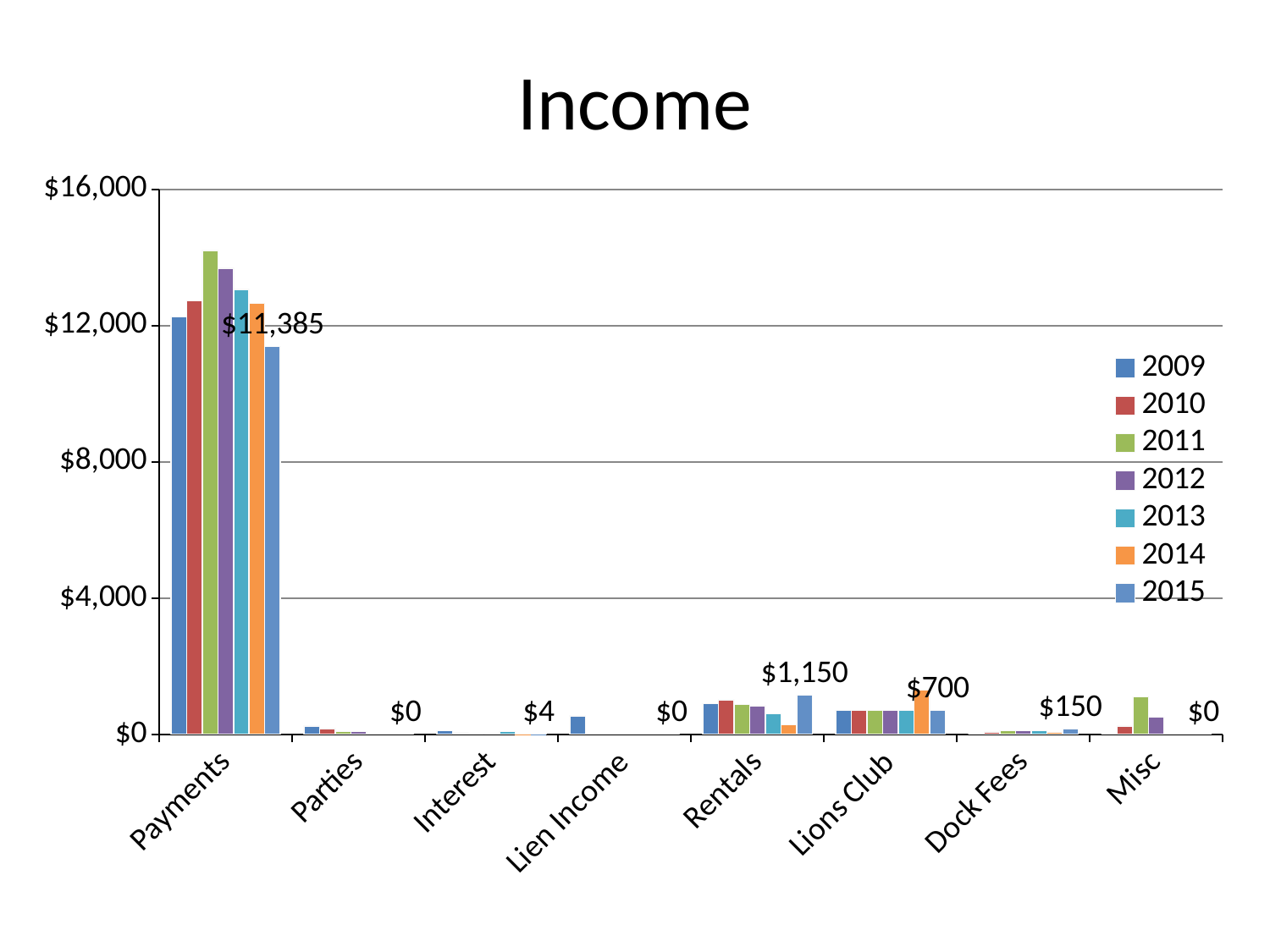
What kind of chart is shown on the slide? bar chart What is the difference between the 2015 values for Rentals and Lions Club? $450 What is the 2015 value for Interest? $4 What is the 2015 value for Dock Fees? $150 What is the 2015 value for Payments? $11,385 Which year has the highest Payments value? 2011 What is the title of the chart? Income How many income categories are shown on the x axis? 8 How many series does the legend list? 7 Is the 2011 value for Payments greater or less than $12,000? greater What is the 2015 value for Rentals? $1,150 What is the 2015 value for Lions Club? $700